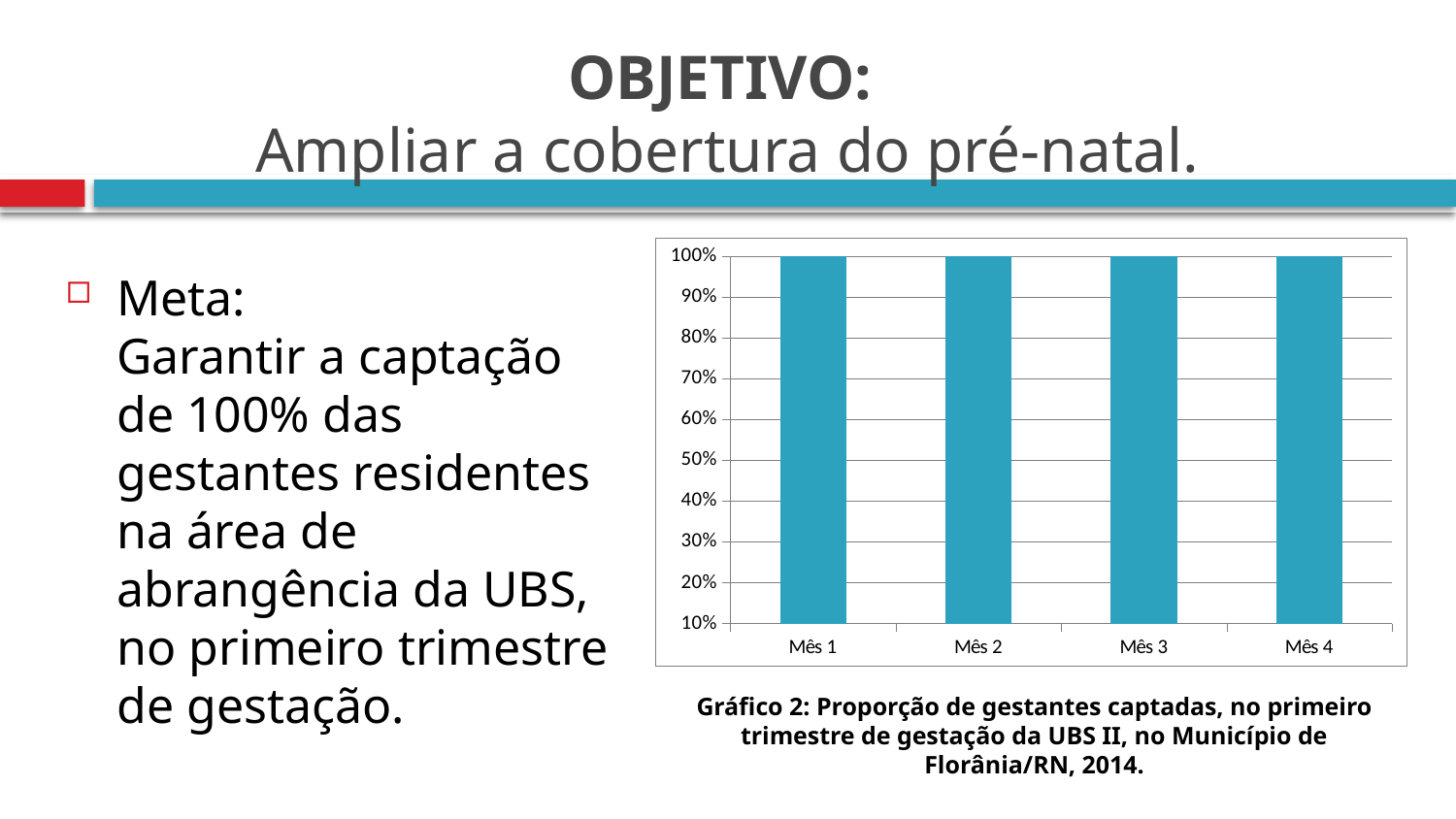
What is the value for Mês 1 in the chart? 100% Do the values rise, fall, or stay flat from Mês 1 to Mês 4? stay flat What is the lowest value shown on the y axis of the chart? 10% What is the difference between the values for Mês 1 and Mês 4? 0% How many categories (months) are plotted on the x axis of the chart? 4 What colour are the bars in the chart? blue What is the value for Mês 3 in the chart? 100% Is the value for Mês 4 greater or less than 50%? greater Is the value for Mês 2 greater or less than 90%? greater What type of chart is shown on the slide? bar chart What is the value for Mês 4 in the chart? 100%